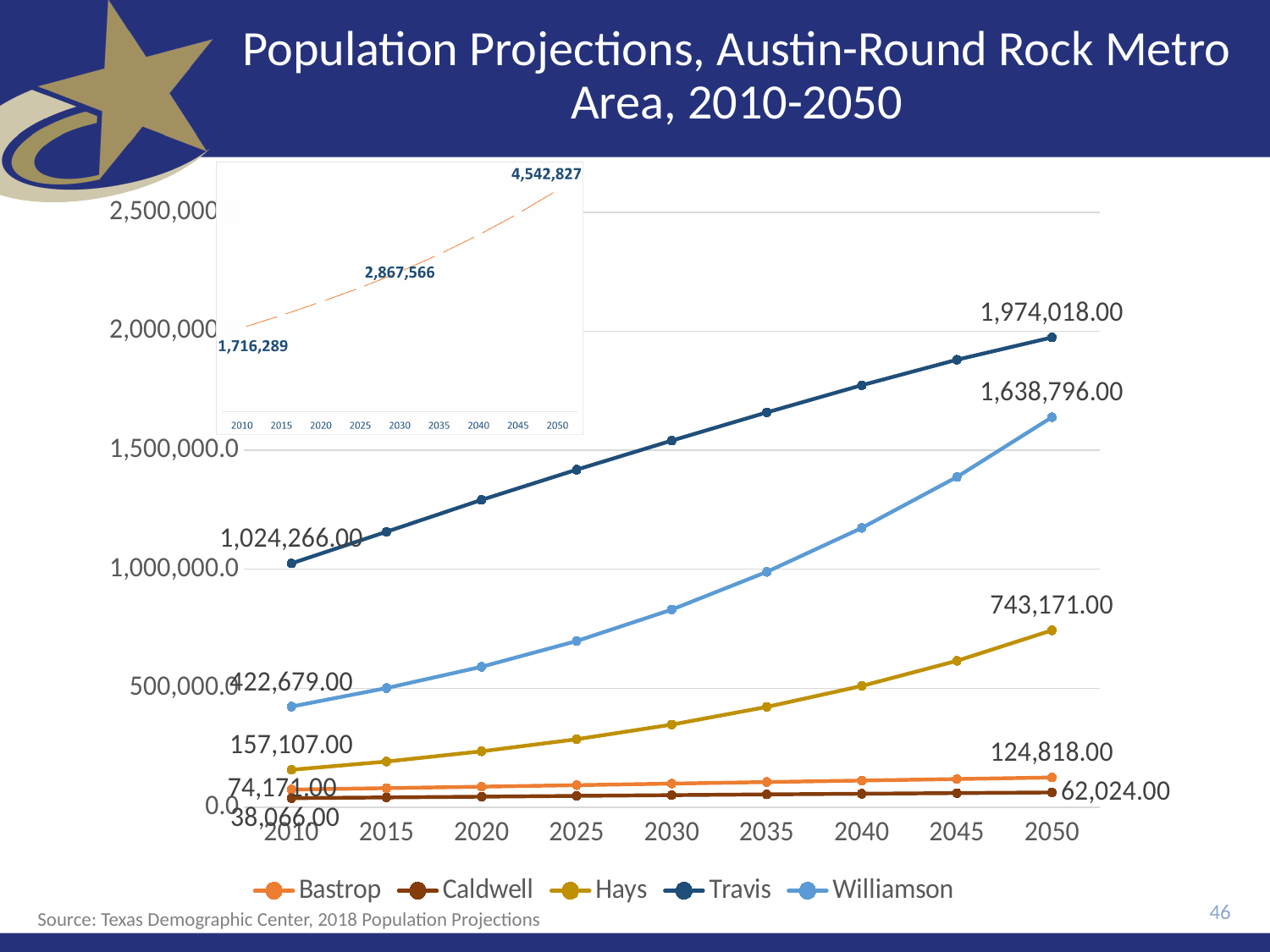
In the main chart, what is the projected population of Caldwell County in 2010? 38,066.00 In the main chart, is the 2050 value for Bastrop larger or smaller than the 2050 value for Hays? smaller In the small inset chart, what is the value labelled for 2050? 4,542,827 In the main chart, which county has the lowest projected population in 2050? Caldwell In the main chart, which county has the highest projected population in 2050? Travis In the main chart, what is the projected population of Hays County in 2050? 743,171.00 In the main chart, by how much does the Williamson County population grow from 2010 to 2050? 1,216,117.00 In the main chart, what is the projected population of Williamson County in 2010? 422,679.00 What kind of chart is the main chart on the slide? line chart In the main chart, what is the projected population of Travis County in 2050? 1,974,018.00 How many series does the legend of the main chart list? 5 In the main chart, is the value for Williamson in 2030 greater or less than 1,000,000? less